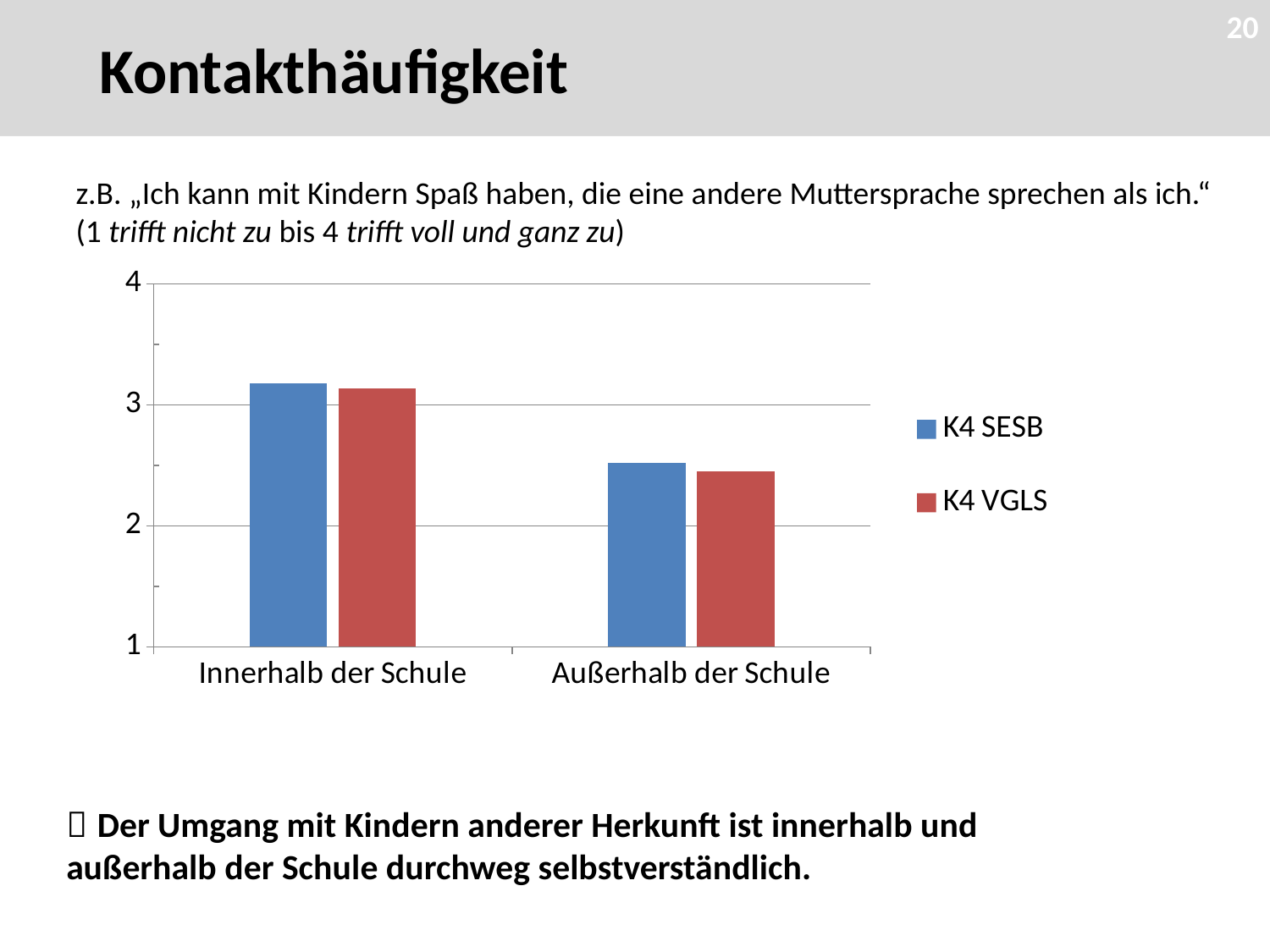
For the K4 SESB series, which category has the higher value: Innerhalb der Schule or Außerhalb der Schule? Innerhalb der Schule Is the value for K4 SESB in Innerhalb der Schule greater or less than 3? greater What kind of chart is shown on the slide? bar chart How many series does the chart's legend list? 2 Is the value for K4 VGLS in Außerhalb der Schule greater or less than 2? greater Which series are listed in the chart's legend? K4 SESB and K4 VGLS What colour are the K4 VGLS bars in the chart? red Do the values for both series rise or fall from Innerhalb der Schule to Außerhalb der Schule? fall Is the value for K4 VGLS in Innerhalb der Schule greater or less than 3? greater For the K4 VGLS series, which category has the lowest value? Außerhalb der Schule How many categories are shown on the x axis of the chart? 2